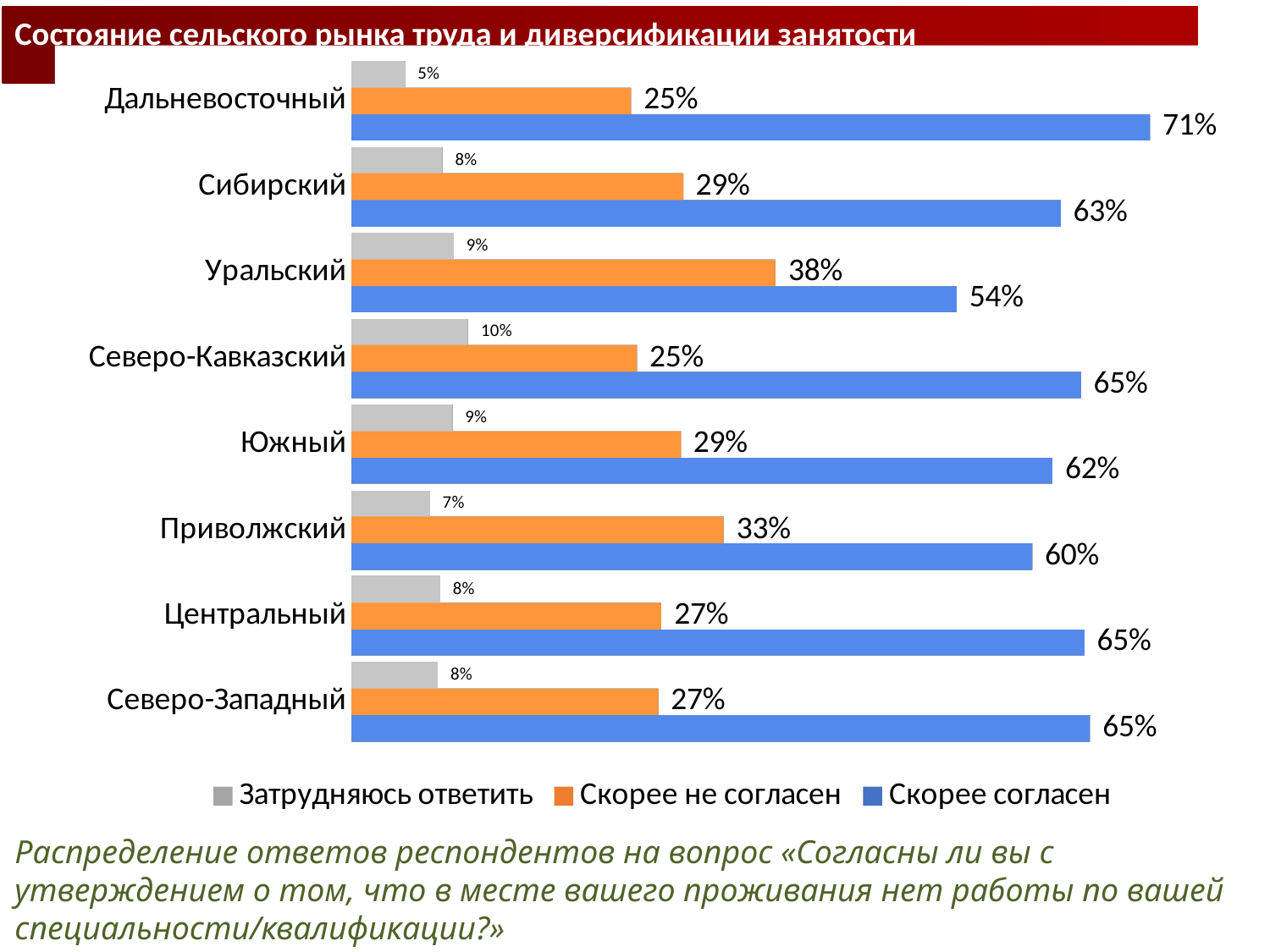
Which colour represents «Скорее не согласен» in the chart? Orange What is the value of «Затрудняюсь ответить» for Северо-Кавказский? 10% Which region has the highest value for «Скорее согласен»? Дальневосточный What is the value of «Скорее согласен» for Дальневосточный? 71% What kind of chart is shown on the slide? Bar chart What is the difference between the «Скорее согласен» values for Дальневосточный and Уральский? 17% Which region has the lowest value for «Затрудняюсь ответить»? Дальневосточный How many series does the legend list? 3 What is the value of «Скорее не согласен» for Уральский? 38% How many regions are shown in the chart? 8 Which is larger: the «Скорее не согласен» value for Приволжский or for Центральный? Приволжский Which region has the lowest value for «Скорее согласен»? Уральский